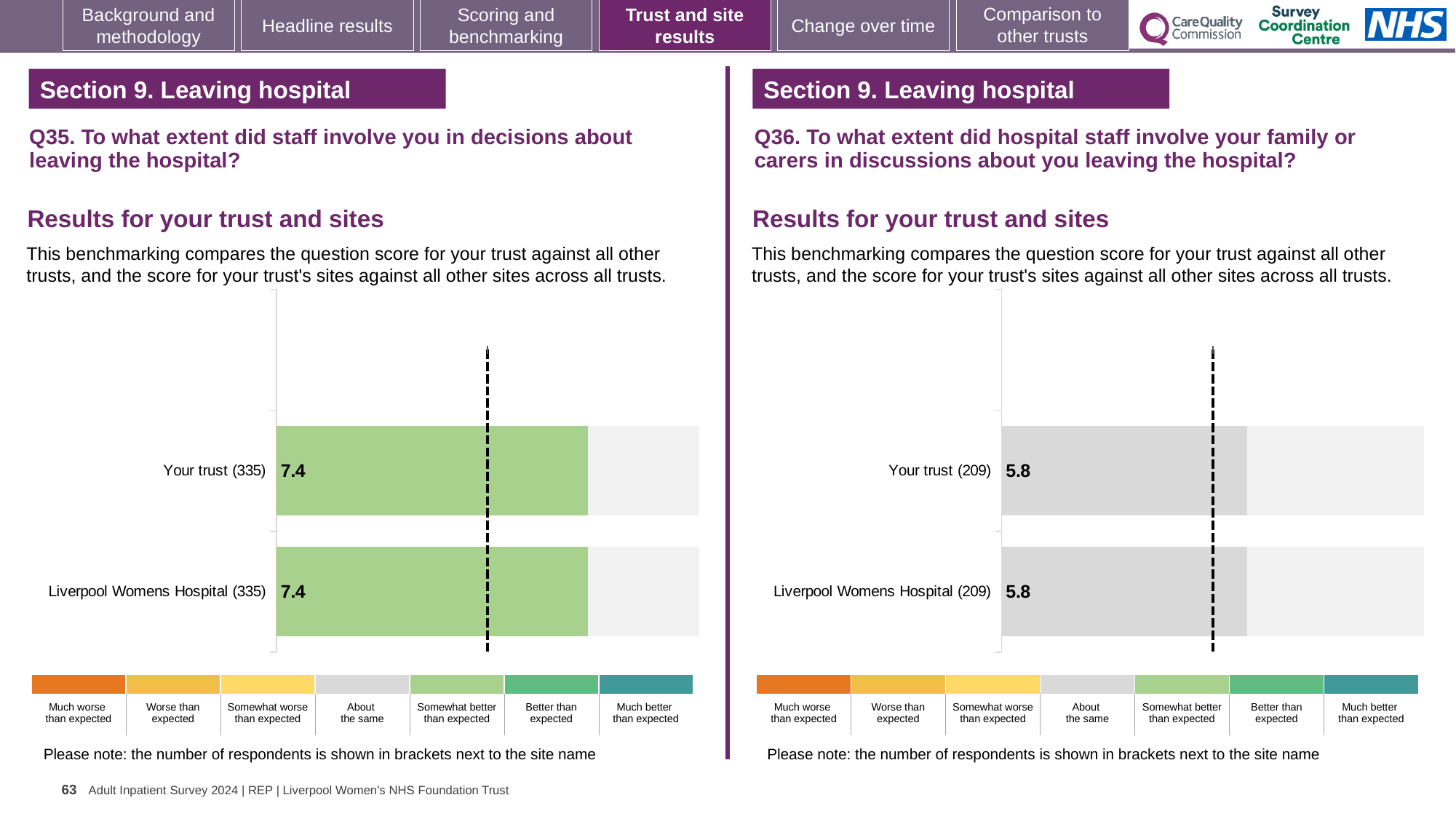
In the Q35 chart on the left, what is the score for Liverpool Womens Hospital? 7.4 What kind of chart is used in the Q35 chart on the left? Bar chart How many bars are plotted in the Q36 chart on the right? 2 In the Q35 chart on the left, what is the score for Your trust? 7.4 How many bars are plotted in the Q35 chart on the left? 2 In the Q36 chart on the right, what is the difference between the score for Your trust and the score for Liverpool Womens Hospital? 0 In the Q36 chart on the right, how many respondents are shown in brackets for Liverpool Womens Hospital? 209 According to the colour key, which benchmark category do the grey bars in the Q36 chart on the right represent? About the same In the Q36 chart on the right, what is the score for Your trust? 5.8 In the Q35 chart on the left, how many respondents are shown in brackets for Your trust? 335 In the Q36 chart on the right, what is the score for Liverpool Womens Hospital? 5.8 In the Q35 chart on the left, what is the difference between the score for Your trust and the score for Liverpool Womens Hospital? 0